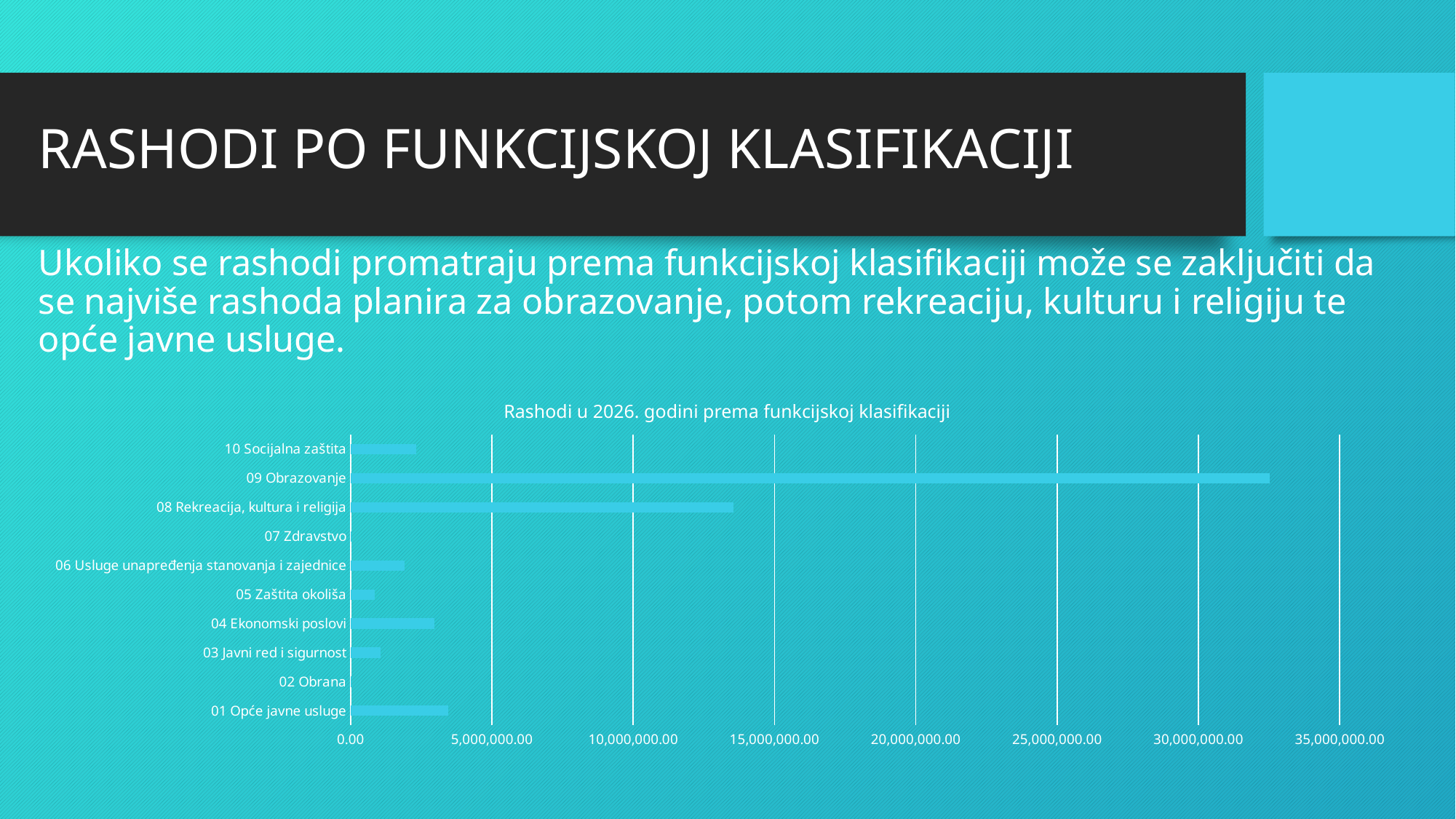
Which is larger, the value for 08 Rekreacija, kultura i religija or the value for 01 Opće javne usluge? 08 Rekreacija, kultura i religija Is the value for 01 Opće javne usluge greater or less than 5,000,000.00? less Is the value for 08 Rekreacija, kultura i religija greater or less than 15,000,000.00? less Which is larger, the value for 04 Ekonomski poslovi or the value for 10 Socijalna zaštita? 04 Ekonomski poslovi What is the title of the chart? Rashodi u 2026. godini prema funkcijskoj klasifikaciji Which category has the highest value in the chart? 09 Obrazovanje Which category has the second highest value in the chart? 08 Rekreacija, kultura i religija Is the value for 09 Obrazovanje greater or less than 30,000,000.00? greater How many categories are plotted in the chart? 10 What kind of chart is shown on the slide? bar chart What is the highest value shown on the horizontal axis of the chart? 35,000,000.00